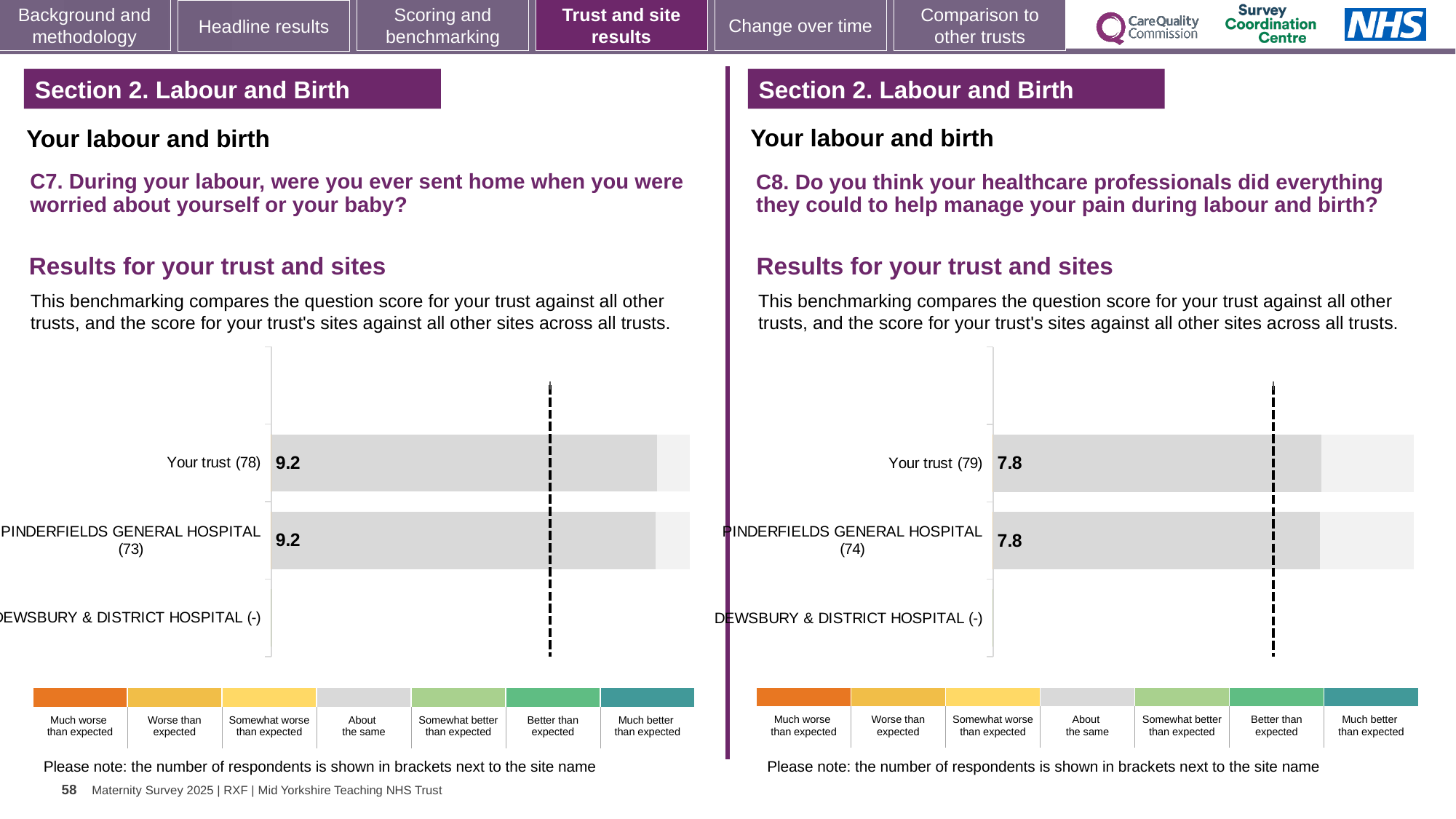
In the C7 chart on the left, what is the score for Your trust? 9.2 In the C8 chart on the right, how many respondents are shown in brackets for Pinderfields General Hospital? 74 How many categories (rows) are listed in the C7 chart on the left? 3 Is the score for Your trust in the C8 chart on the right larger or smaller than the score for Your trust in the C7 chart on the left? Smaller In the C7 chart on the left, how many respondents are shown in brackets for Your trust? 78 How many categories (rows) are listed in the C8 chart on the right? 3 In the C8 chart on the right, what is the score for Pinderfields General Hospital? 7.8 In the C7 chart on the left, what is the difference between the score for Your trust and the score for Pinderfields General Hospital? 0 In the C7 chart on the left, what is the score for Pinderfields General Hospital? 9.2 In the C8 chart on the right, what is the score for Your trust? 7.8 What kind of chart is used for the C7 results on the left? Bar chart In the C8 chart on the right, what is the difference between the score for Your trust and the score for Pinderfields General Hospital? 0